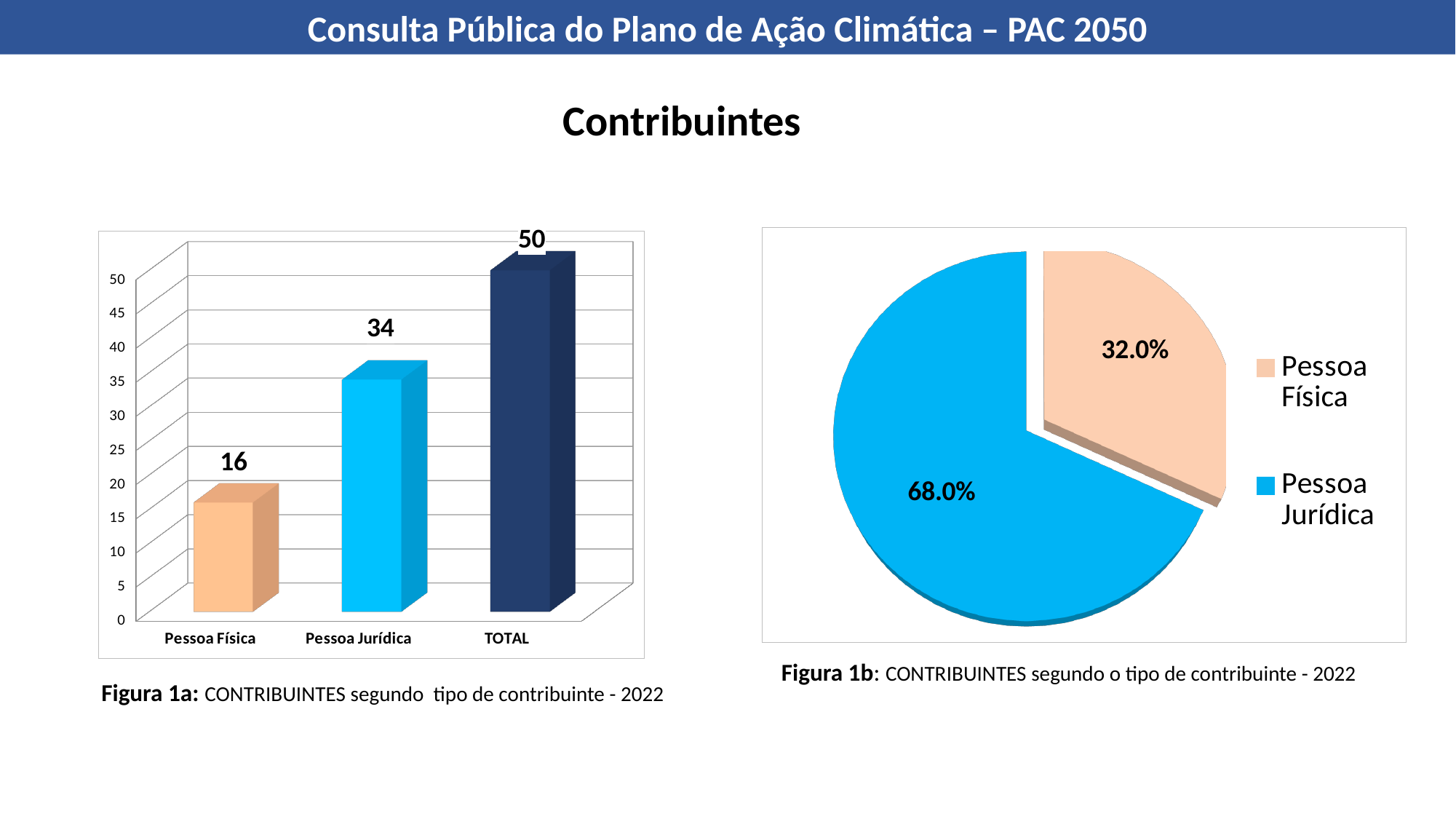
In the bar chart on the left (Figura 1a), what is the difference between Pessoa Jurídica and Pessoa Física? 18 In the bar chart on the left (Figura 1a), what is the value for Pessoa Jurídica? 34 In the bar chart on the left (Figura 1a), what is the value for TOTAL? 50 In the bar chart on the left (Figura 1a), what is the value for Pessoa Física? 16 How many entries does the legend of the pie chart on the right (Figura 1b) list? 2 What kind of chart is Figura 1a on the left? Bar chart In the bar chart on the left (Figura 1a), which is larger, Pessoa Física or Pessoa Jurídica? Pessoa Jurídica In the bar chart on the left (Figura 1a), which category has the lowest value? Pessoa Física In the pie chart on the right (Figura 1b), what share does Pessoa Física have? 32.0% In the pie chart on the right (Figura 1b), what share does Pessoa Jurídica have? 68.0% What kind of chart is Figura 1b on the right? Pie chart How many categories are shown in the bar chart on the left (Figura 1a)? 3